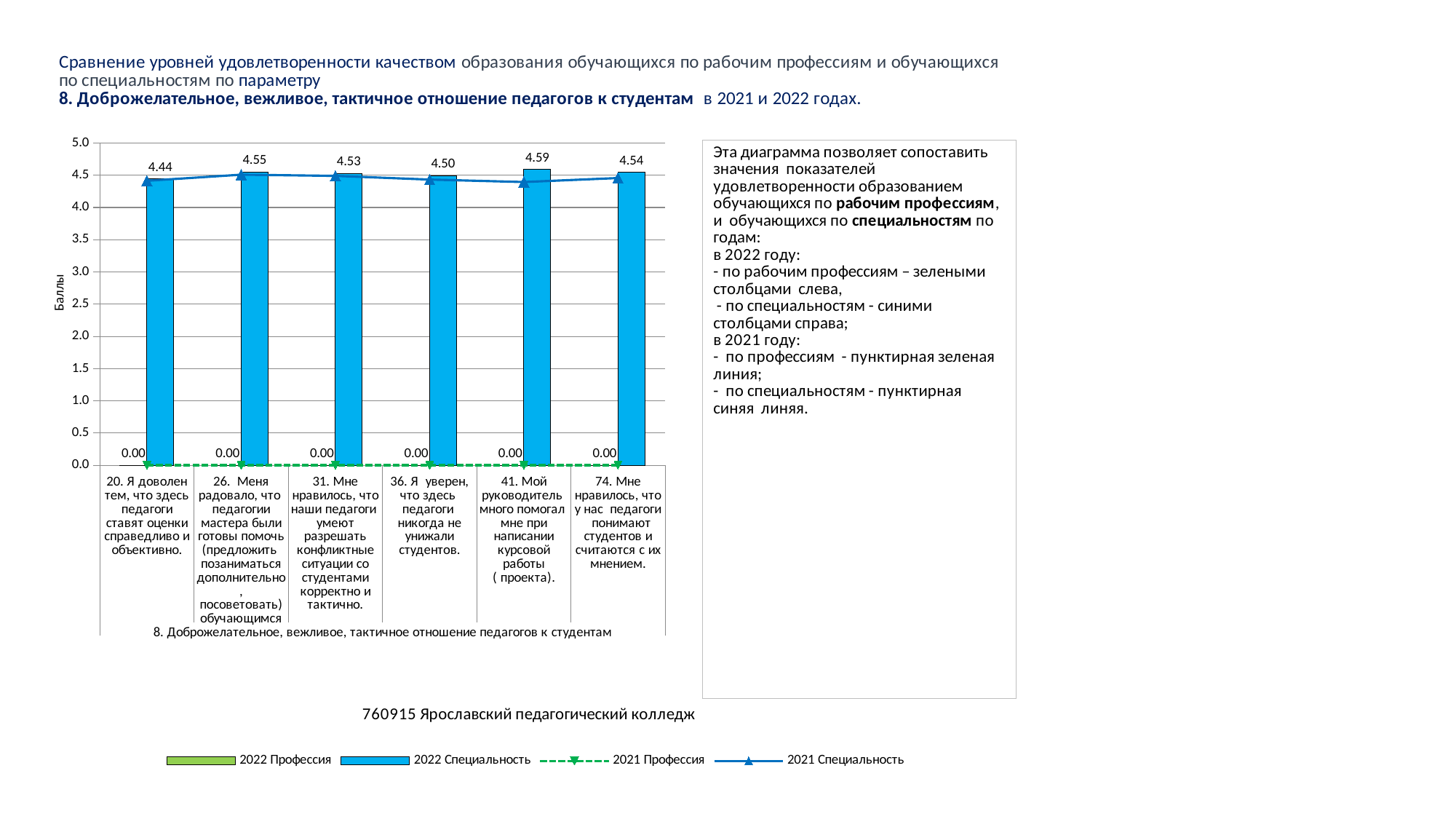
What is the label of the vertical axis? Баллы Is the 2021 Специальность value for item 31 greater or less than 4.0? greater What is the 2022 Специальность value for item 36 (Я уверен, что здесь педагоги никогда не унижали студентов)? 4.50 Which item has the highest 2022 Специальность value? 41. Мой руководитель много помогал мне при написании курсовой работы (проекта). What is the 2022 Специальность value for item 41 (Мой руководитель много помогал мне при написании курсовой работы)? 4.59 What is the 2022 Специальность value for item 20 (Я доволен тем, что здесь педагоги ставят оценки справедливо и объективно)? 4.44 How many items (categories) are shown on the x axis? 6 What is the 2022 Профессия value for item 74 (Мне нравилось, что у нас педагоги понимают студентов и считаются с их мнением)? 0.00 Which is larger, the 2022 Специальность value for item 26 or for item 31? Item 26 (4.55) How many series does the legend list? 4 What is the difference between the 2022 Специальность values for item 41 and item 20? 0.15 Which item has the lowest 2022 Специальность value? 20. Я доволен тем, что здесь педагоги ставят оценки справедливо и объективно.